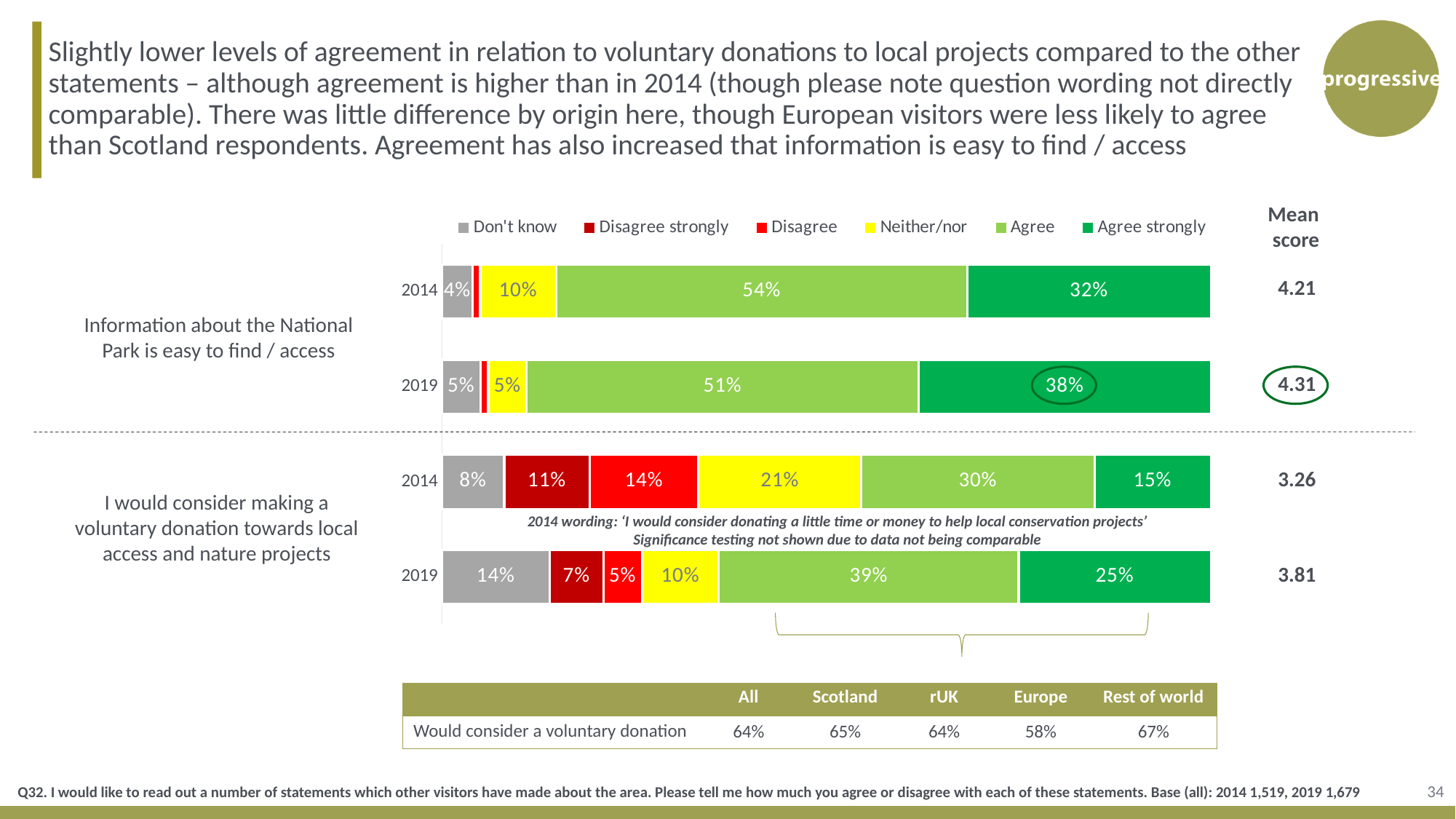
What is the mean score shown for the 2019 'Information about the National Park is easy to find / access' statement? 4.31 In 2014, what percentage of respondents said they 'Agree' that they would consider making a voluntary donation towards local access and nature projects? 30% What is the combined share of 'Agree' and 'Agree strongly' for the voluntary donation statement in 2019? 64% Which response category has the largest share in the 2019 bar for the voluntary donation statement? Agree What percentage of 2014 respondents disagreed strongly with the voluntary donation statement? 11% What type of chart is used to show the agreement levels? Stacked bar chart How many response categories does the chart legend list? 6 By how many percentage points did 'Agree strongly' for the voluntary donation statement change from 2014 (15%) to 2019 (25%)? 10 percentage points For the statement that information about the National Park is easy to find / access, was the 'Agree' share larger in 2014 or 2019? 2014 What percentage of 2019 respondents answered 'Don't know' for the voluntary donation statement? 14% What percentage of 2019 respondents agreed strongly that information about the National Park is easy to find / access? 38% How many bars are plotted in the chart in total? 4